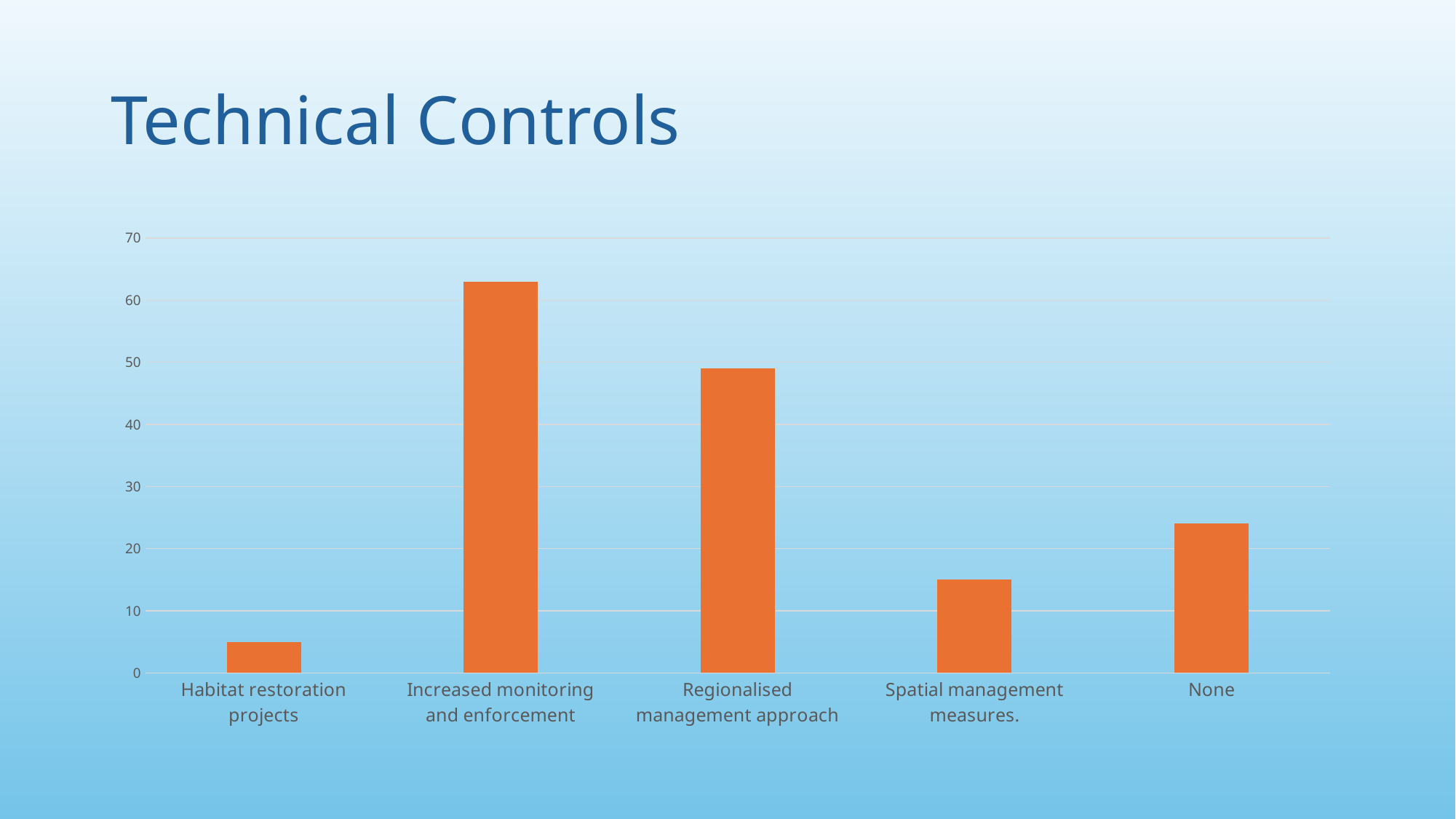
Which category has the lowest bar? Habitat restoration projects How many categories are shown on the x axis of the chart? 5 What is the title of the slide containing the chart? Technical Controls Which is larger, the value for Regionalised management approach or the value for Increased monitoring and enforcement? Increased monitoring and enforcement Is the value for Increased monitoring and enforcement greater or less than 60? greater Is the value for Spatial management measures. greater or less than 10? greater What kind of chart is shown on the slide? Bar chart Is the value for Habitat restoration projects greater or less than 10? less Which is larger, the value for None or the value for Spatial management measures.? None Which category has the highest bar? Increased monitoring and enforcement